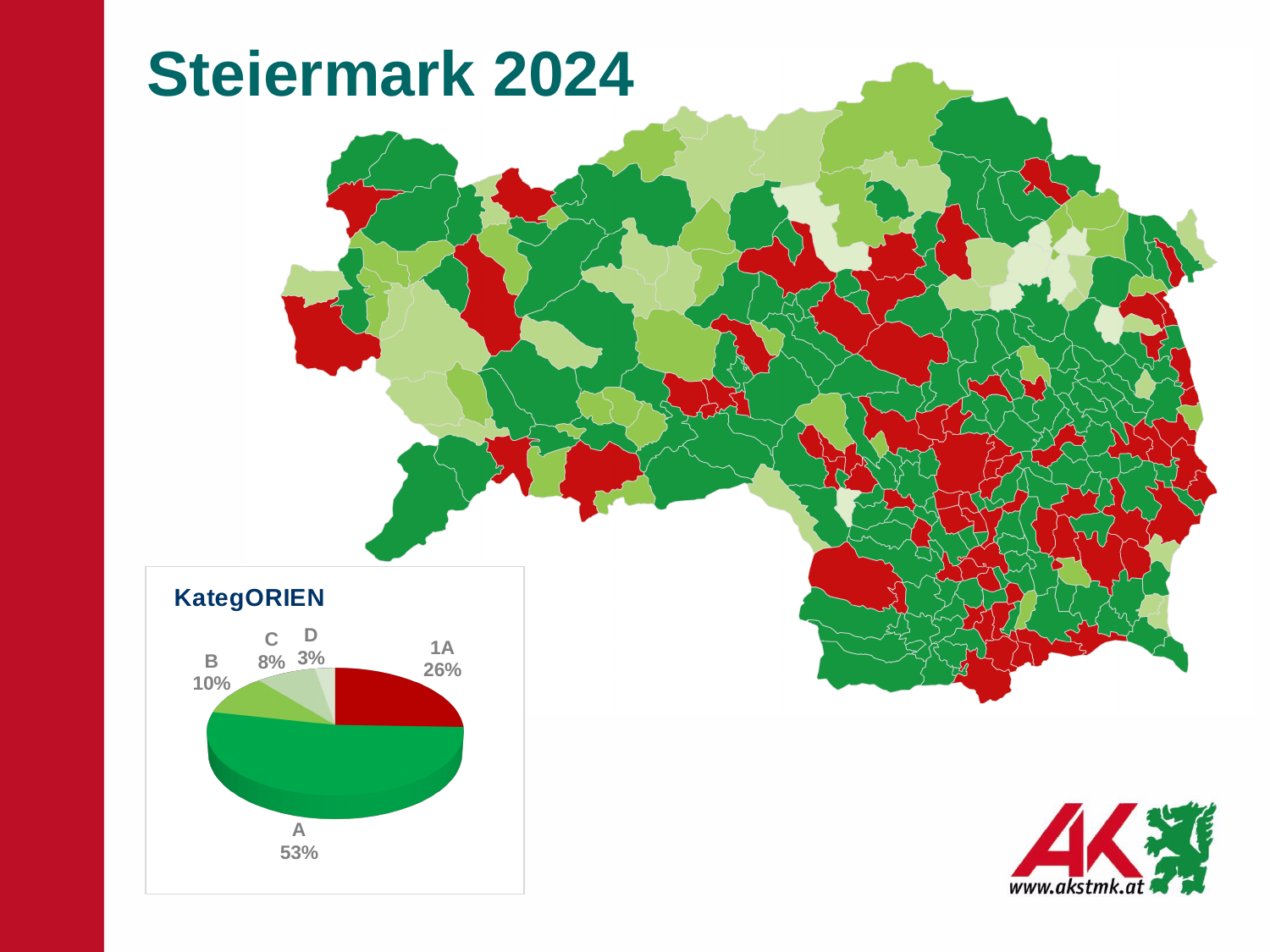
How many slices does the "KategORIEN" pie chart have? 5 In the "KategORIEN" pie chart, what share does category D have? 3% In the "KategORIEN" pie chart, what share does category C have? 8% Which category has the largest slice in the "KategORIEN" pie chart? A What colour is the 1A slice in the "KategORIEN" pie chart? red Which category has the smallest slice in the "KategORIEN" pie chart? D What kind of chart is shown in the "KategORIEN" box? pie chart In the "KategORIEN" pie chart, how many percentage points larger is A than 1A? 27 In the "KategORIEN" pie chart, what share does category A have? 53% In the "KategORIEN" pie chart, which is larger, B or C? B In the "KategORIEN" pie chart, what share does category 1A have? 26% In the "KategORIEN" pie chart, what share does category B have? 10%